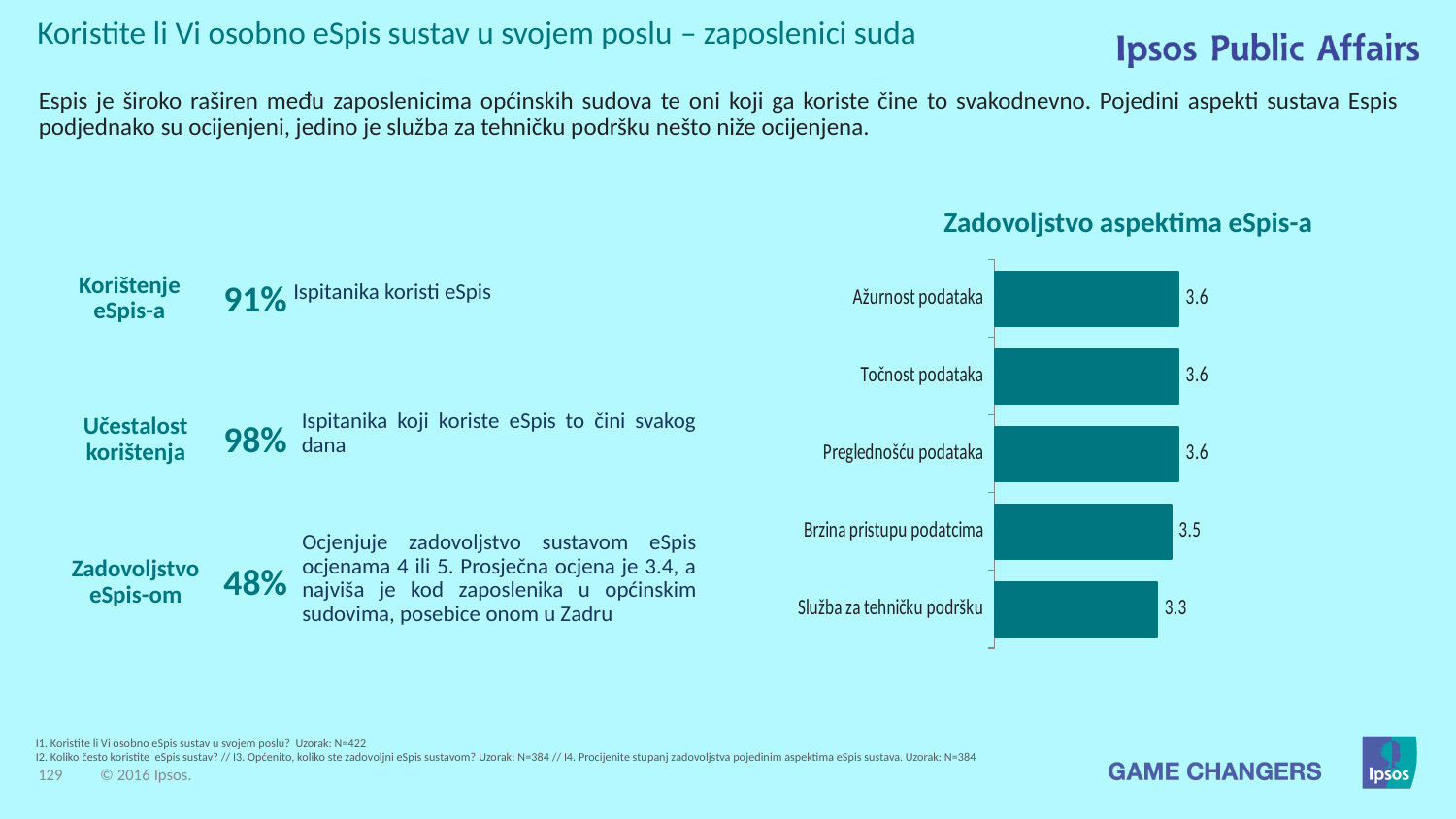
What is the difference between the values for Ažurnost podataka and Služba za tehničku podršku? 0.3 What is the value for Ažurnost podataka in the chart? 3.6 What is the value for Preglednošću podataka in the chart? 3.6 What is the value for Točnost podataka in the chart? 3.6 Which is larger, the value for Točnost podataka or the value for Služba za tehničku podršku? Točnost podataka What is the value for Brzina pristupu podatcima in the chart? 3.5 Which category has the lowest value in the chart? Služba za tehničku podršku What is the value for Služba za tehničku podršku in the chart? 3.3 How many categories are shown in the chart? 5 What is the title of the chart? Zadovoljstvo aspektima eSpis-a What is the difference between the values for Brzina pristupu podatcima and Služba za tehničku podršku? 0.2 What kind of chart is shown on the slide? Bar chart